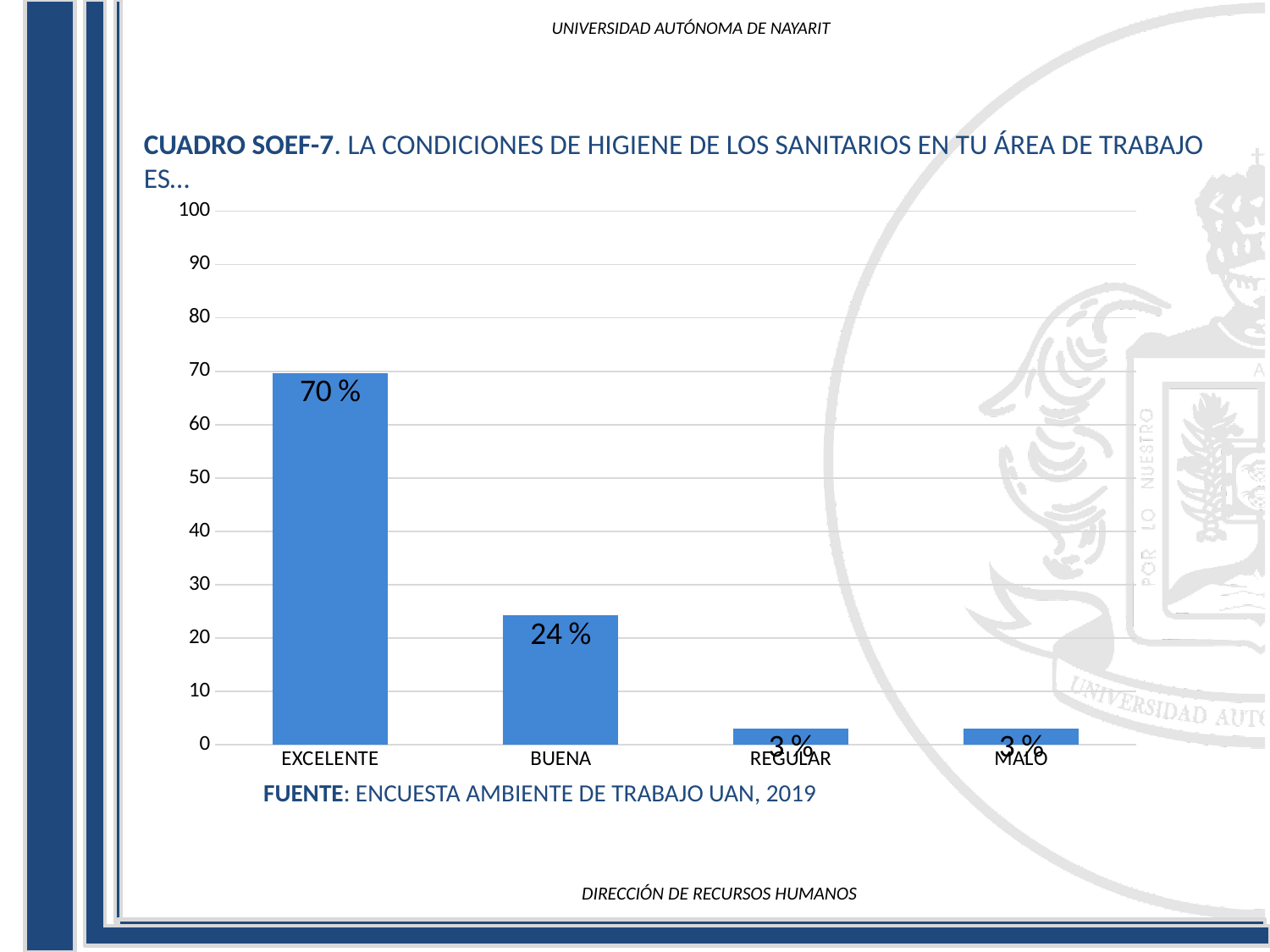
What source is cited below the chart? ENCUESTA AMBIENTE DE TRABAJO UAN, 2019 Which category has the highest value? EXCELENTE What value is shown for the MALO category? 3 % What is the difference between the EXCELENTE and BUENA values? 46 % What percentage of respondents rated the hygiene conditions as EXCELENTE? 70 % How many categories are shown on the x axis? 4 What is the value shown for the BUENA category? 24 % What value is shown for the REGULAR category? 3 % What kind of chart is shown on the slide? bar chart Which is larger, the value for BUENA or the value for REGULAR? BUENA Is the value for EXCELENTE greater or less than 60? greater Do the values rise or fall moving from left to right along the x axis? fall